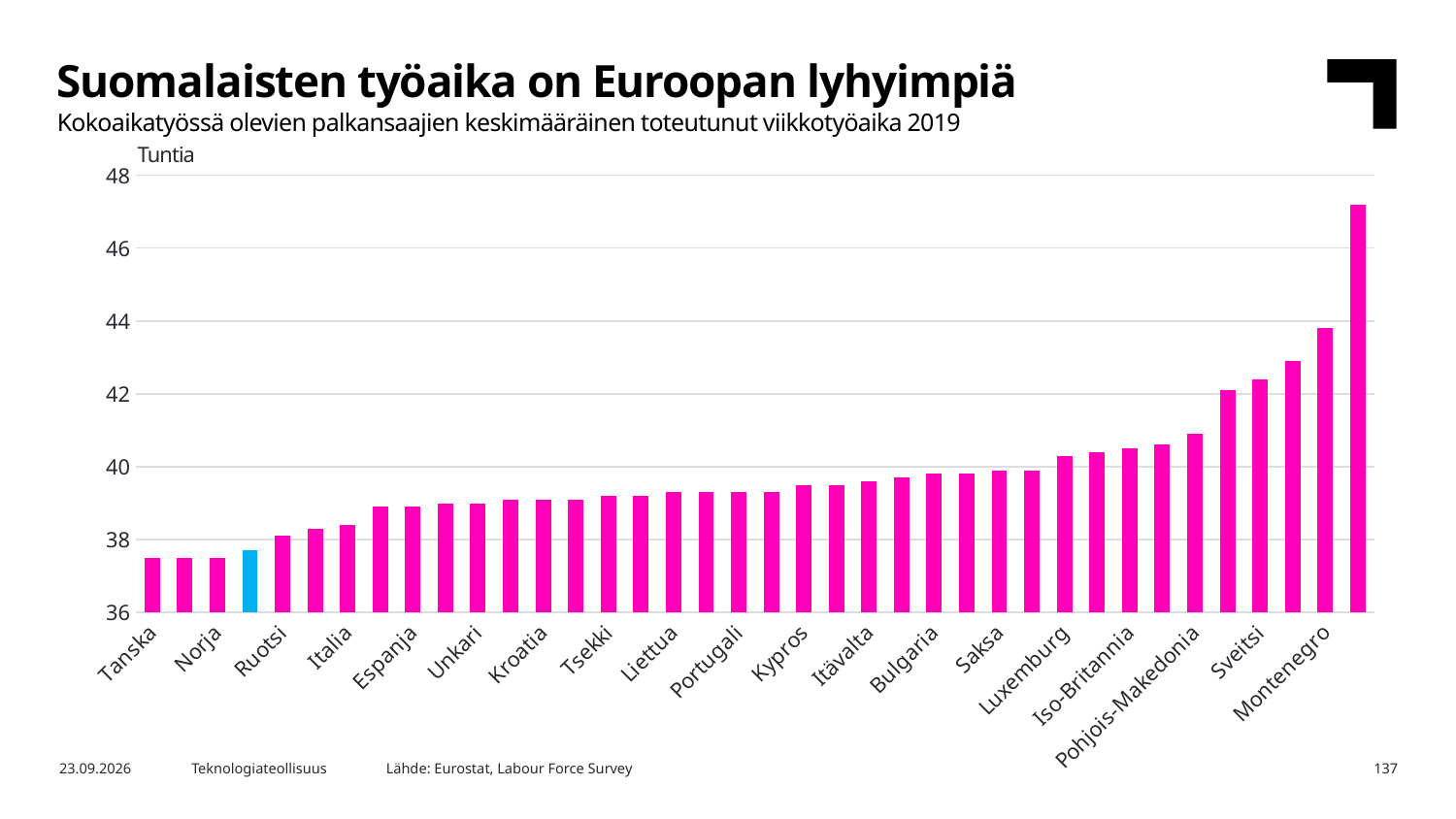
What is the title of the chart on the slide? Suomalaisten työaika on Euroopan lyhyimpiä Is the value for Sveitsi greater or less than 40? greater Is the value for Italia greater or less than 40? less What kind of chart is shown on the slide? bar chart Is the value for Kroatia greater or less than 38? greater Which has a larger value, Montenegro or Tanska? Montenegro Do the bar values rise or fall from left to right along the x axis? rise What unit is shown on the vertical axis of the chart? Tuntia Which has a larger value, Sveitsi or Norja? Sveitsi